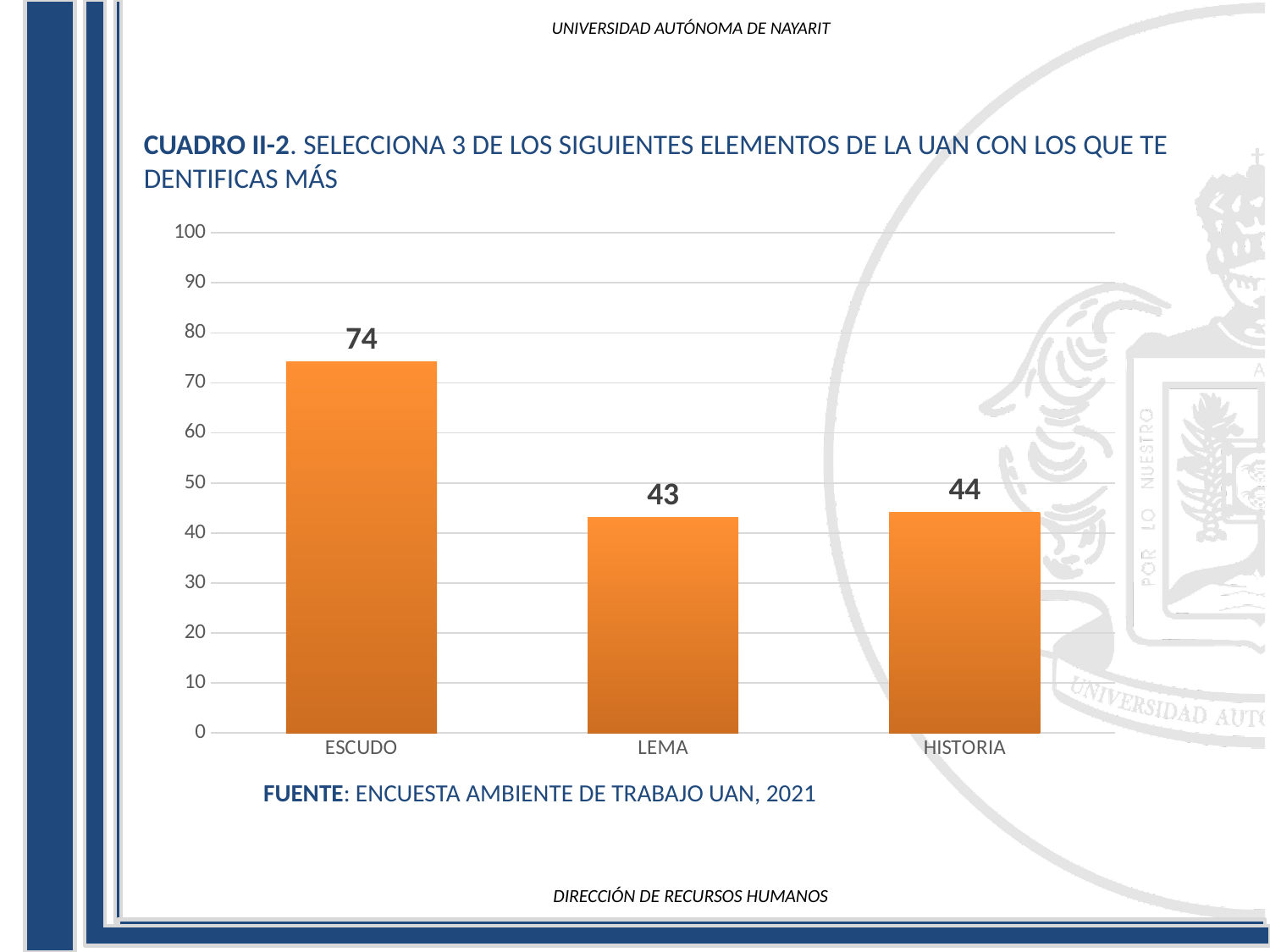
What kind of chart is shown on the slide? bar chart Which category has the lowest value? LEMA Which is larger, the value for ESCUDO or the value for HISTORIA? ESCUDO What is the difference between the values for ESCUDO and HISTORIA? 30 What source is cited below the chart? ENCUESTA AMBIENTE DE TRABAJO UAN, 2021 Is the value for LEMA greater or less than 50? less What is the value for HISTORIA? 44 How many categories are shown in the chart? 3 What is the difference between the values for ESCUDO and LEMA? 31 What is the value for ESCUDO? 74 What is the value for LEMA? 43 Which category has the highest value? ESCUDO